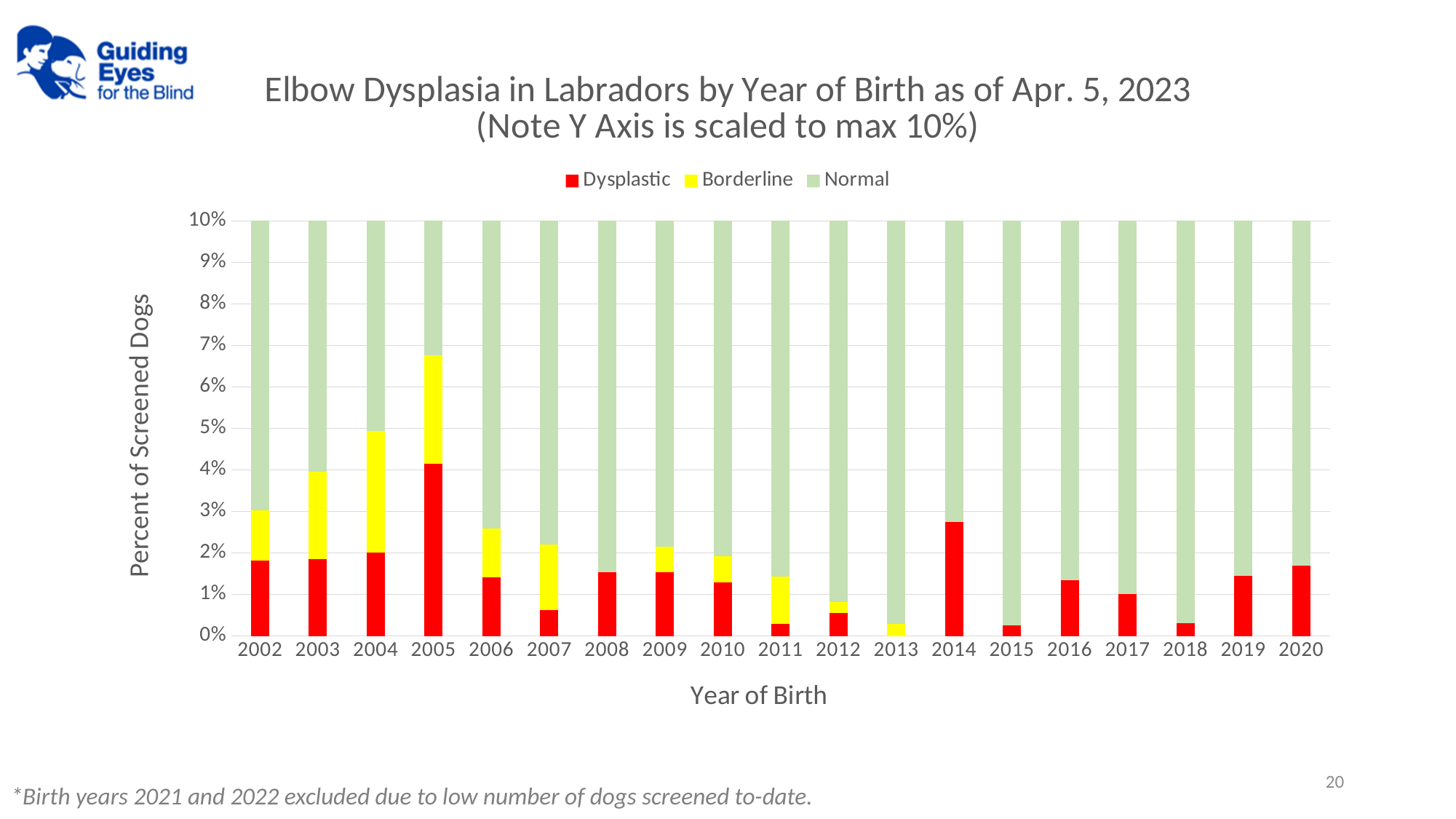
How many series does the legend list? 3 Is the Dysplastic value for 2014 greater or less than 2%? greater Is the Dysplastic value for 2005 greater or less than 3%? greater Which colour represents the Borderline series in the legend? Yellow What is the label of the y axis? Percent of Screened Dogs Which year of birth has the highest Dysplastic percentage? 2005 How many birth years are plotted on the x axis? 19 What kind of chart is shown on the slide? Stacked bar chart Which year of birth shows no Dysplastic segment at all? 2013 Is the Dysplastic value for 2007 greater or less than 1%? less Which year of birth has the largest Borderline segment? 2004 Which year has the larger Dysplastic percentage, 2004 or 2014? 2014